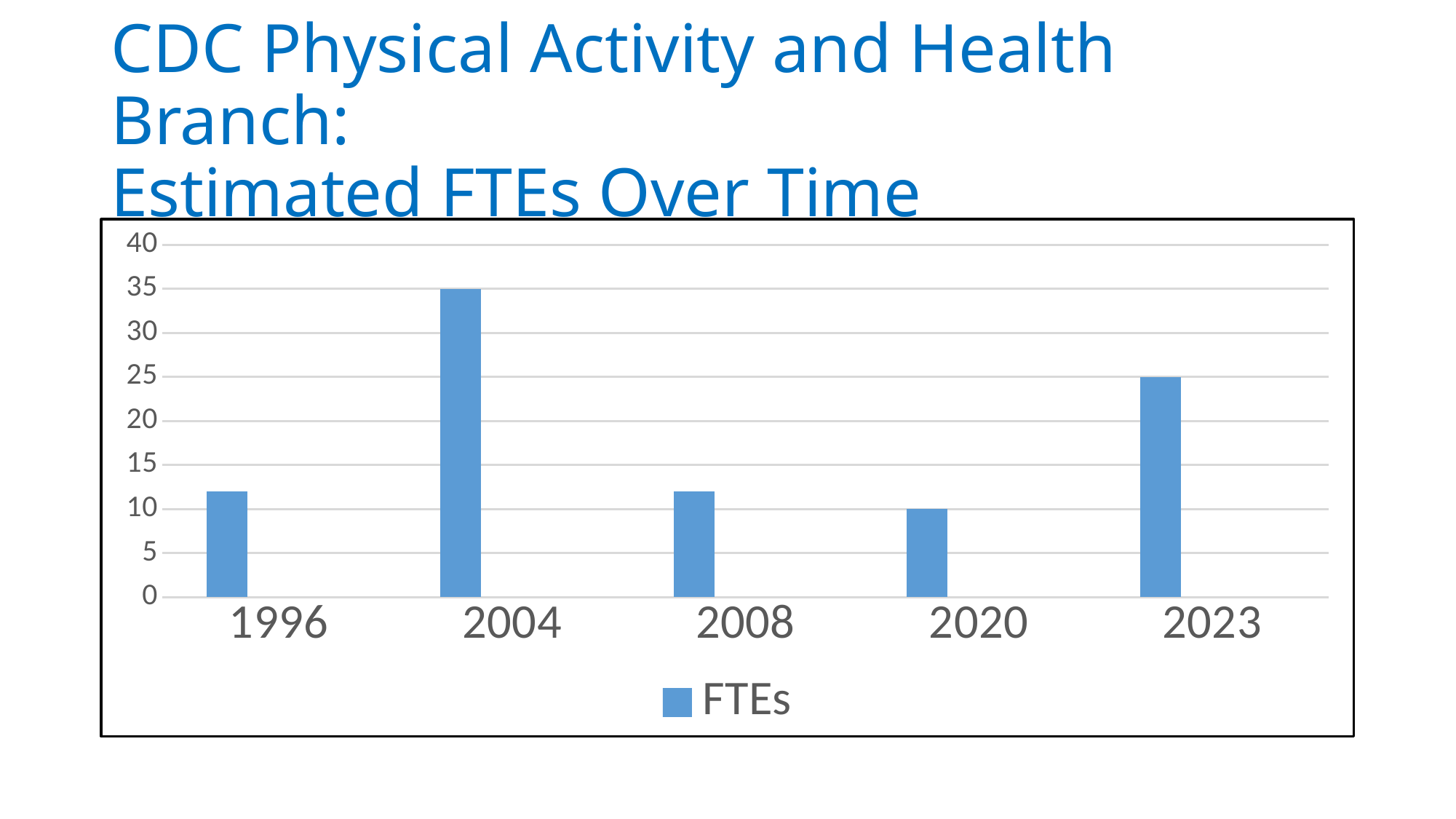
Which is larger, the FTEs in 2023 or in 2008? 2023 What is the difference between the FTEs in 2004 and in 2023? 10 What is the value for FTEs in 2020? 10 What type of chart is shown on the slide? bar chart What is the name of the series shown in the legend? FTEs How many years are shown on the x axis of the chart? 5 What is the value for FTEs in 2004? 35 What is the value for FTEs in 2023? 25 Is the value for FTEs in 1996 greater or less than 10? greater Which year has the lowest number of FTEs? 2020 How many series does the chart legend list? 1 Which year has the highest number of FTEs? 2004